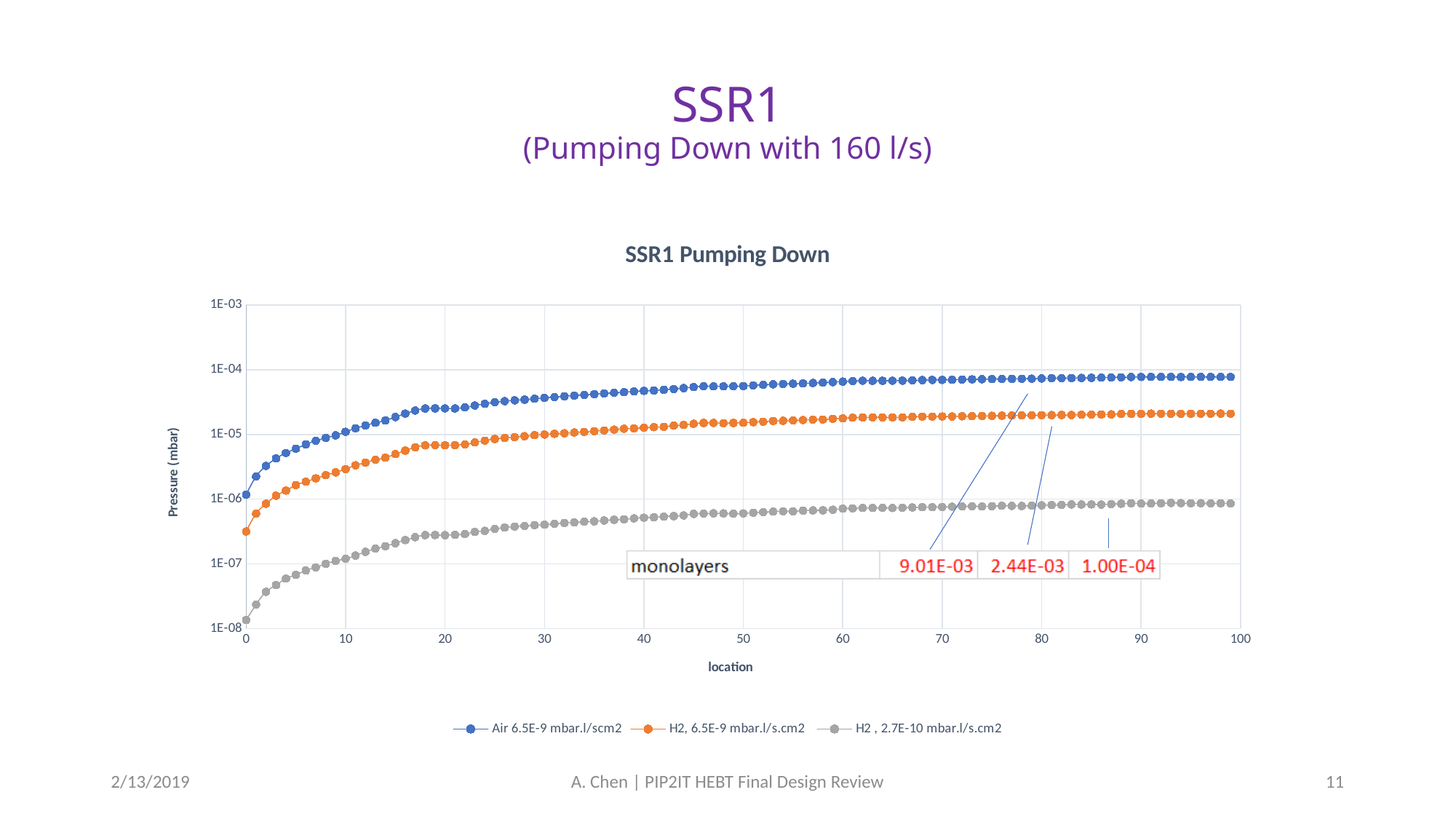
What kind of chart is shown on the slide? line chart Is the pressure for the H2 , 2.7E-10 mbar.l/s.cm2 series at location 50 greater or less than 1E-06? less What is the label of the y axis? Pressure (mbar) Is the pressure for the H2, 6.5E-9 mbar.l/s.cm2 series at location 100 greater or less than 1E-05? greater How many series does the chart legend list? 3 Do the pressure values rise or fall as location increases along the x axis? rise At location 50, which series has the higher pressure: Air 6.5E-9 mbar.l/scm2 or H2, 6.5E-9 mbar.l/s.cm2? Air 6.5E-9 mbar.l/scm2 Which series has the highest pressure values across the chart? Air 6.5E-9 mbar.l/scm2 Is the pressure for the H2, 6.5E-9 mbar.l/s.cm2 series at location 0 greater or less than 1E-06? less Which series has the lowest pressure values across the chart? H2 , 2.7E-10 mbar.l/s.cm2 What is the title of the chart? SSR1 Pumping Down